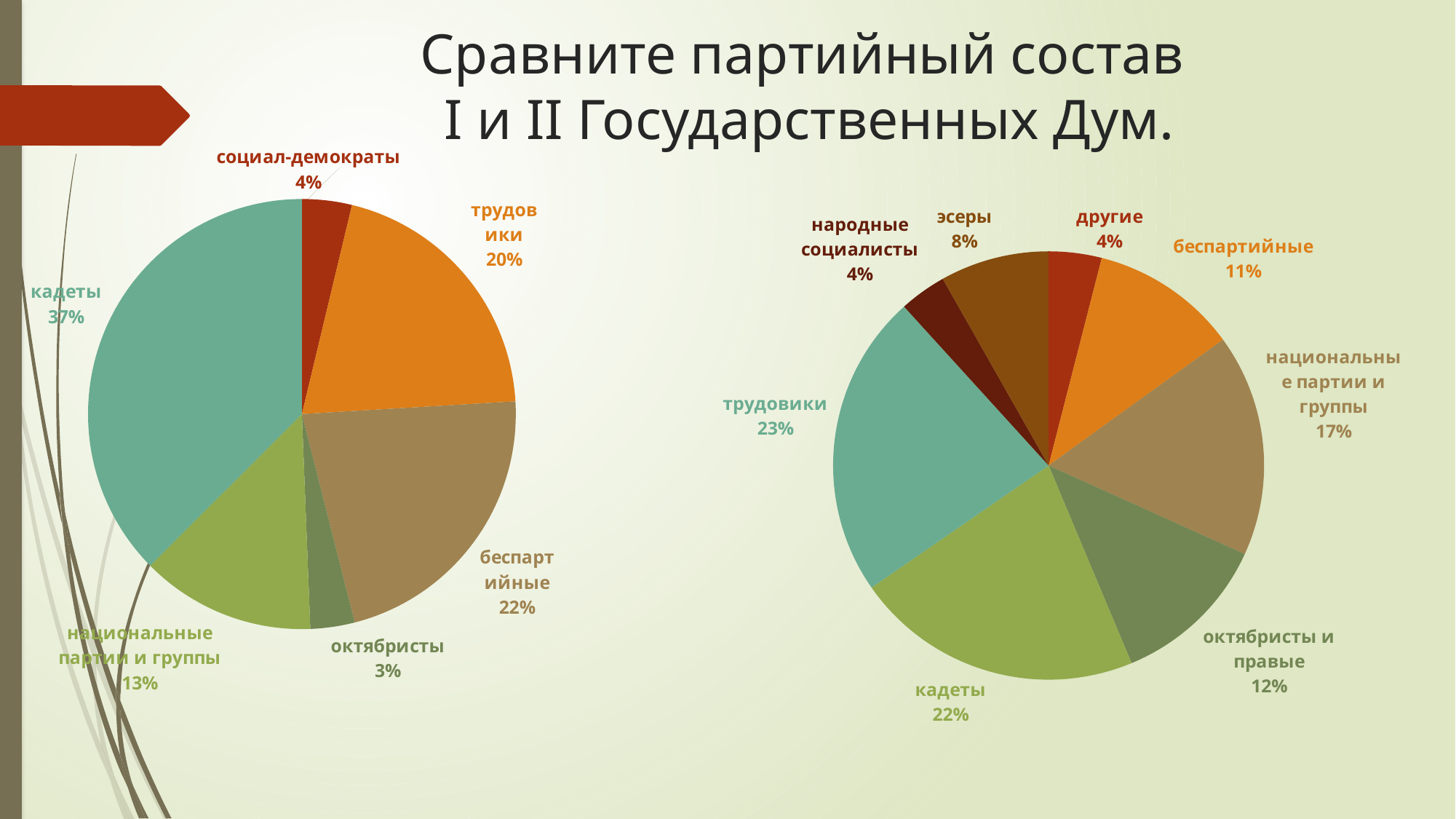
In the right pie chart, which category has the largest share? трудовики In the right pie chart, what share do трудовики have? 23% In the left pie chart, what is the difference between the shares of трудовики and национальные партии и группы? 7% In the right pie chart, how many slices are there? 8 In the left pie chart, which category has the largest share? кадеты In the left pie chart, what share do беспартийные have? 22% In the left pie chart, what share do кадеты have? 37% In the left pie chart, which category has the smallest share? октябристы In the right pie chart, what share do национальные партии и группы have? 17% In the left pie chart, how many slices are there? 6 In the right pie chart, which is larger: the share of эсеры or the share of беспартийные? беспартийные What type of chart is shown on the right side of the slide? pie chart